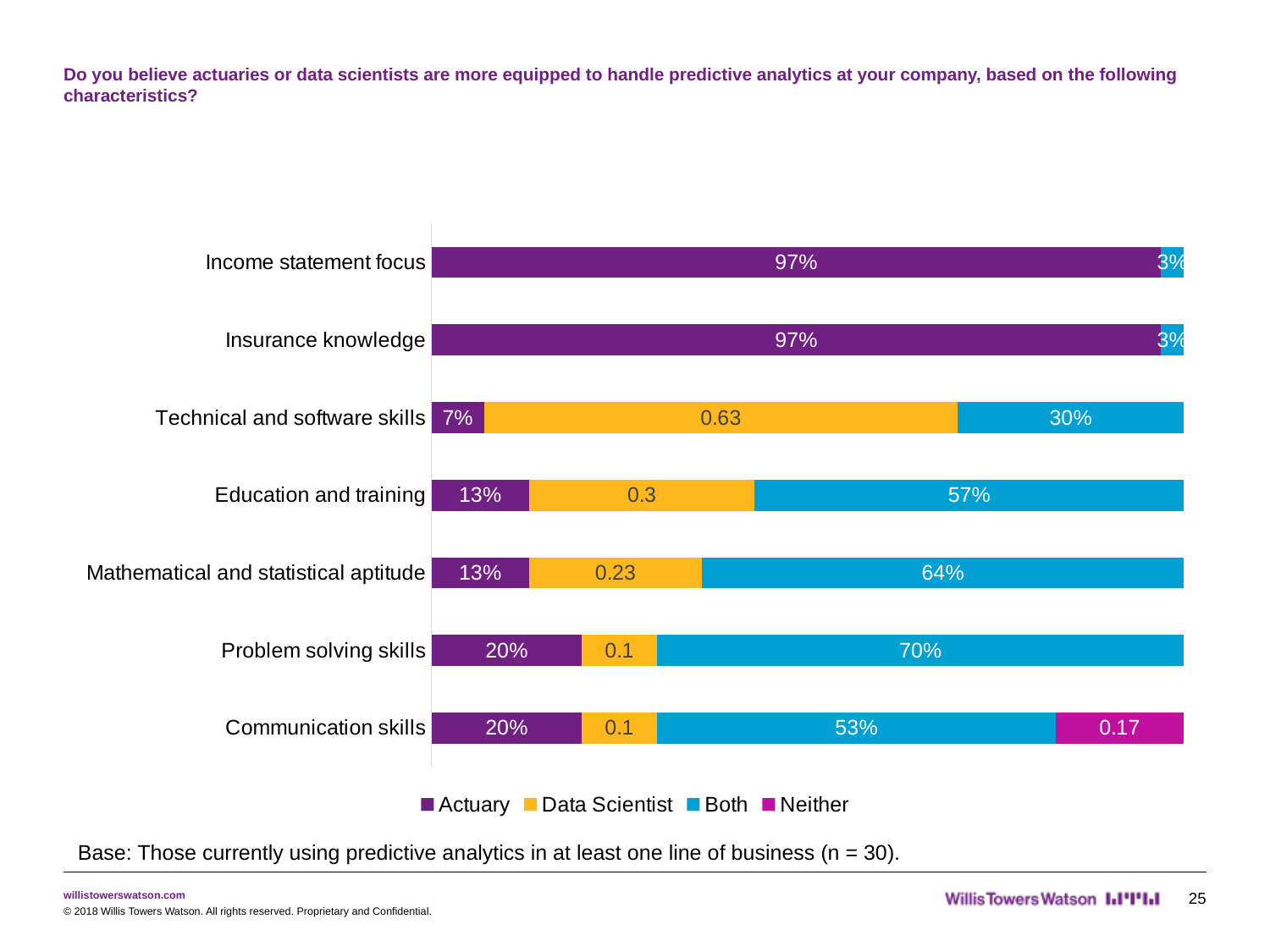
What kind of chart is shown on the slide? Stacked bar chart Which characteristic has the lowest Actuary value? Technical and software skills How many series does the legend list? 4 What is the Actuary value for Insurance knowledge? 97% How many characteristics (categories) are plotted on the chart? 7 What is the Data Scientist value shown for Technical and software skills? 0.63 What is the difference between the Both values for Problem solving skills and Communication skills? 17 percentage points Which series is shown in yellow in the legend? Data Scientist Which is larger: the Both value for Education and training or the Both value for Technical and software skills? Education and training Which characteristic has the highest Both value? Problem solving skills What is the Neither value shown for Communication skills? 0.17 What is the Both value for Mathematical and statistical aptitude? 64%